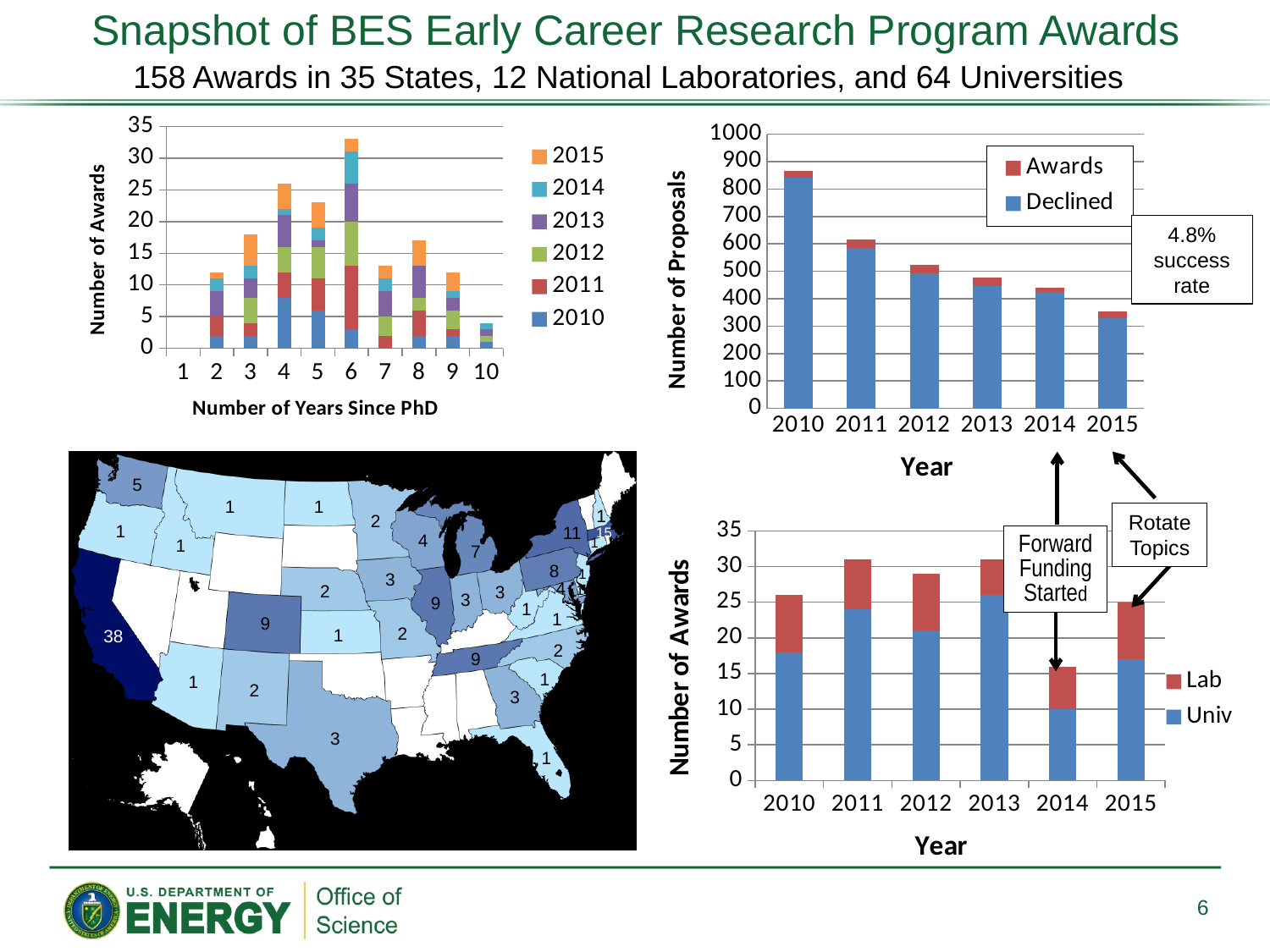
In the top-right chart (Number of Proposals by Year), is the total number of proposals in 2010 greater or less than 800? greater What kind of chart is the top-left chart of Number of Awards by Number of Years Since PhD? bar chart What success rate is stated in the text box next to the top-right chart (Number of Proposals by Year)? 4.8% success rate In the top-left chart (Number of Awards vs Number of Years Since PhD), how many series does the legend list? 6 In the top-left chart (Number of Awards vs Number of Years Since PhD), is the total number of awards for 10 years since PhD greater or less than 5? less In the top-right chart (Number of Proposals by Year), do the total proposals rise or fall from 2010 to 2015? fall In the top-right chart (Number of Proposals by Year), which year has the highest total number of proposals? 2010 In the top-left chart (Number of Awards vs Number of Years Since PhD), which number of years since PhD has the tallest stacked bar? 6 In the bottom-right chart (Number of Awards by Year), which year has the lowest total number of awards? 2014 In the bottom-right chart (Number of Awards by Year), what are the two series listed in the legend? Lab and Univ In the top-right chart (Number of Proposals by Year), how many years are shown on the x axis? 6 In the top-left chart (Number of Awards vs Number of Years Since PhD), is the total number of awards for 6 years since PhD greater or less than 30? greater